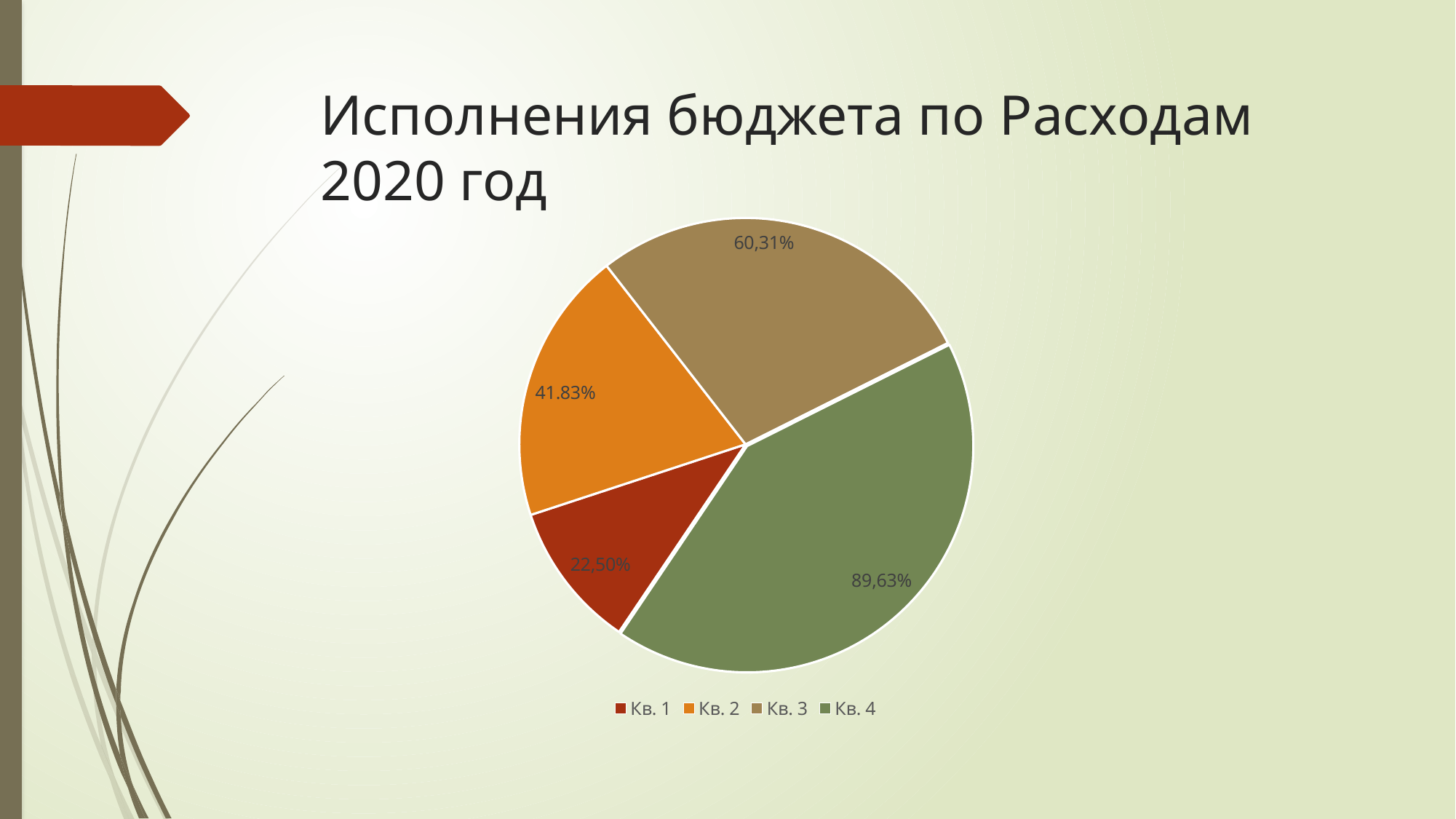
What value is labelled on the Кв. 2 slice? 41.83% Which slice has the highest labelled value? Кв. 4 Which has the larger labelled value, Кв. 2 or Кв. 3? Кв. 3 How many slices does the pie chart have? 4 What kind of chart is shown on the slide? Pie chart What is the difference between the labelled values of Кв. 4 and Кв. 3? 29,32% How many entries does the legend list? 4 What value is labelled on the Кв. 4 slice? 89,63% What value is labelled on the Кв. 3 slice? 60,31% What is the title of the slide? Исполнения бюджета по Расходам 2020 год Which slice has the lowest labelled value? Кв. 1 What value is labelled on the Кв. 1 slice? 22,50%